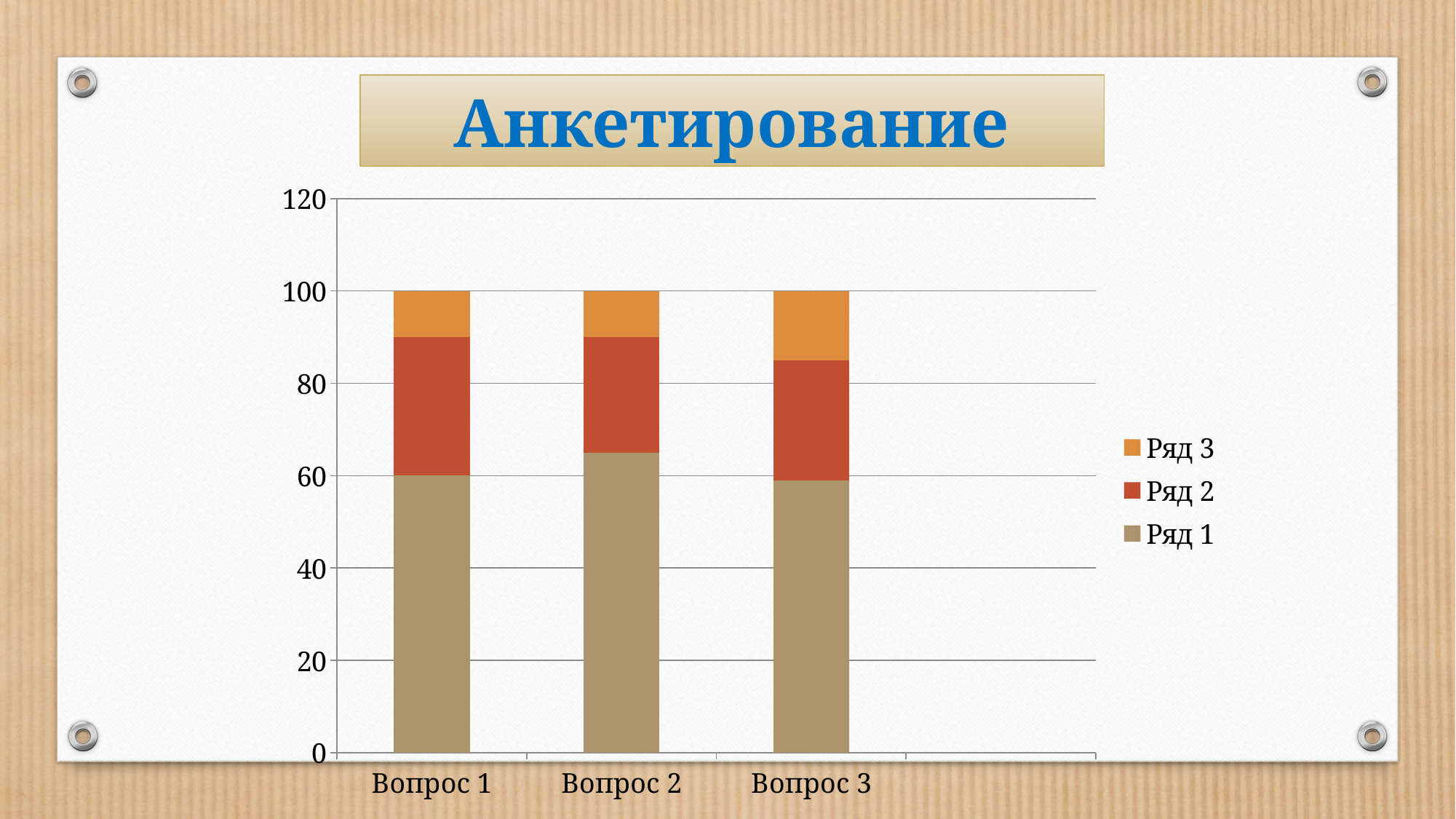
What are the legend entries of the chart? Ряд 3, Ряд 2, Ряд 1 What is the title of the slide? Анкетирование How many categories are shown on the x axis? 3 What is the value of Ряд 1 for Вопрос 1? 60 Is the value of Ряд 1 for Вопрос 3 greater or less than 40? greater What is the total of the stacked bar for Вопрос 3? 100 What is the total of the stacked bar for Вопрос 1? 100 What kind of chart is shown on the slide? Stacked bar chart For which category is the Ряд 1 value the highest? Вопрос 2 Is the value of Ряд 1 for Вопрос 2 greater or less than 60? greater How many series does the legend list? 3 Which is larger: the Ряд 3 segment for Вопрос 3 or the Ряд 3 segment for Вопрос 1? Вопрос 3